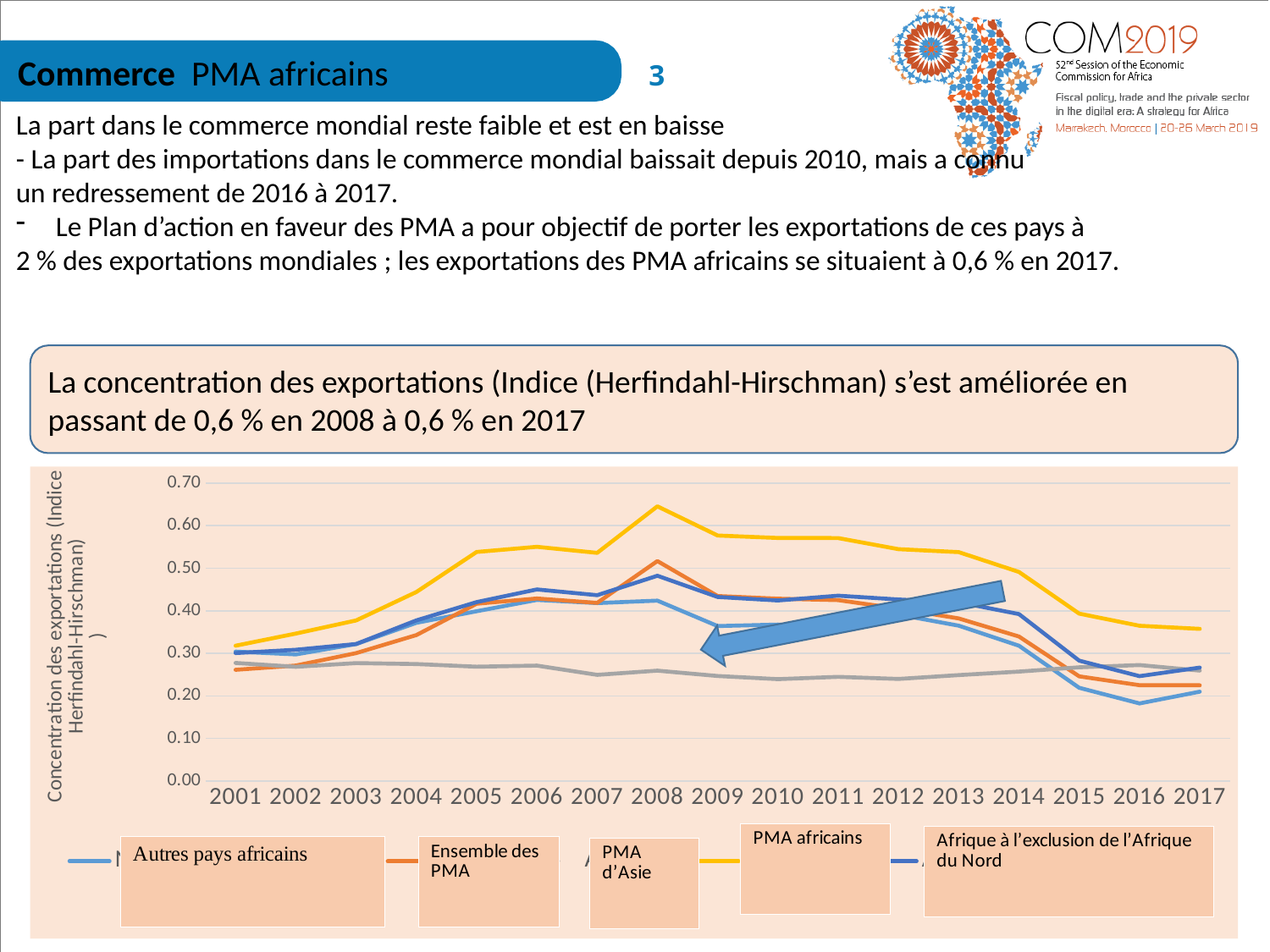
What kind of chart is shown on the slide? line chart What is the first year shown on the x axis of the chart? 2001 How many years are shown along the x axis of the chart? 17 Which series has the lowest value in 2016? Autres pays africains How many series does the chart's legend list? 5 Is the value for PMA d'Asie in 2010 greater or less than 0.30? less In 2017, which is larger: the value for PMA africains or the value for PMA d'Asie? PMA africains Is the value for Ensemble des PMA in 2001 greater or less than 0.30? less Which series has the highest value in 2008? PMA africains Is the value for PMA africains in 2008 greater or less than 0.60? greater Does the PMA africains series rise or fall between 2008 and 2017? fall Does the PMA africains series rise or fall between 2001 and 2008? rise